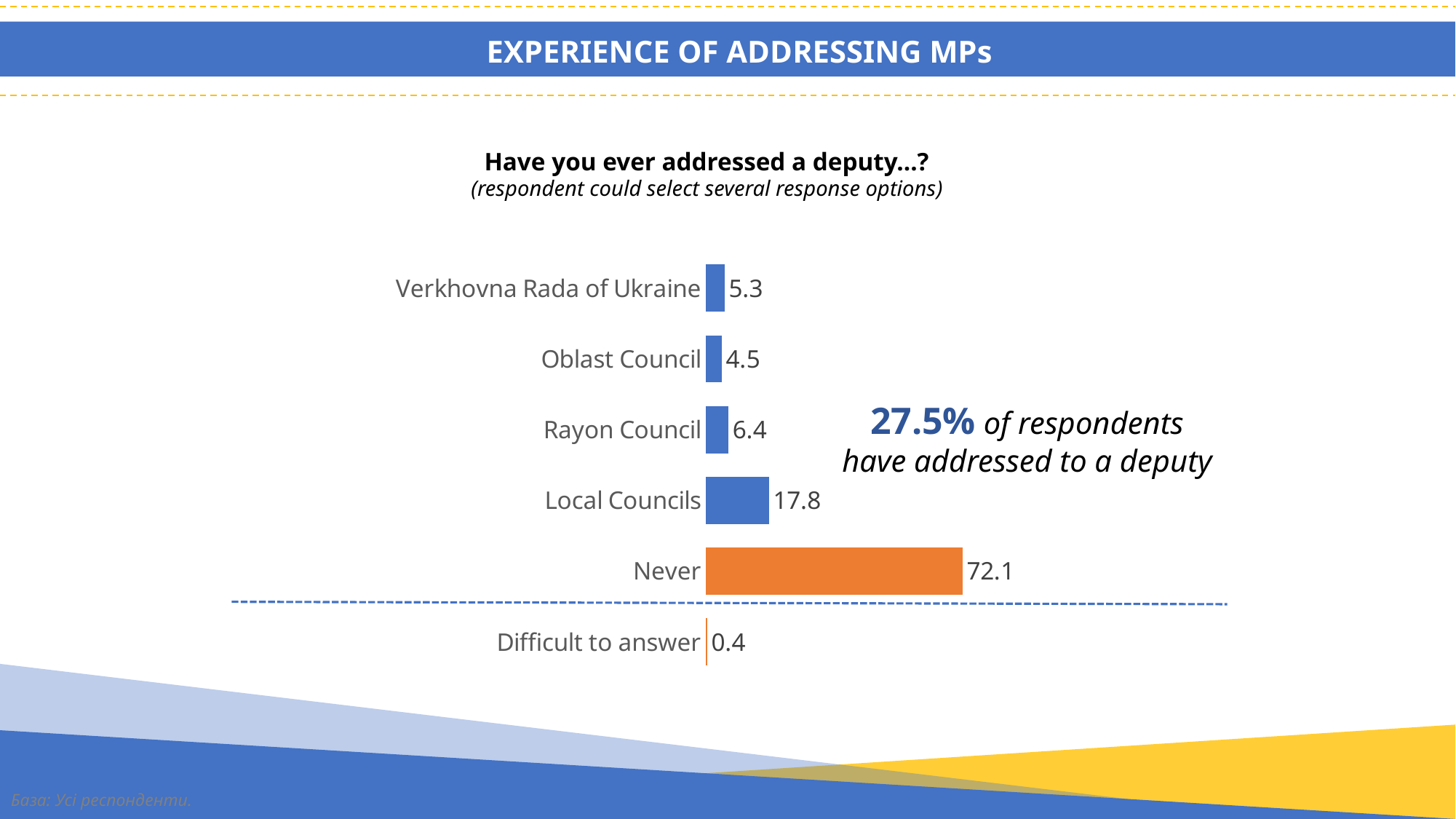
What kind of chart is shown on the slide? Bar chart Which is larger, the value for Rayon Council or the value for Oblast Council? Rayon Council What is the value for Never? 72.1 Which category has the lowest value? Difficult to answer What colour is the bar for Never? Orange How many categories are shown in the chart? 6 What is the difference between the values for Local Councils and Rayon Council? 11.4 What is the difference between the values for Never and Local Councils? 54.3 What is the value for Difficult to answer? 0.4 What is the value for Local Councils? 17.8 Which category has the highest value? Never What is the value for Verkhovna Rada of Ukraine? 5.3